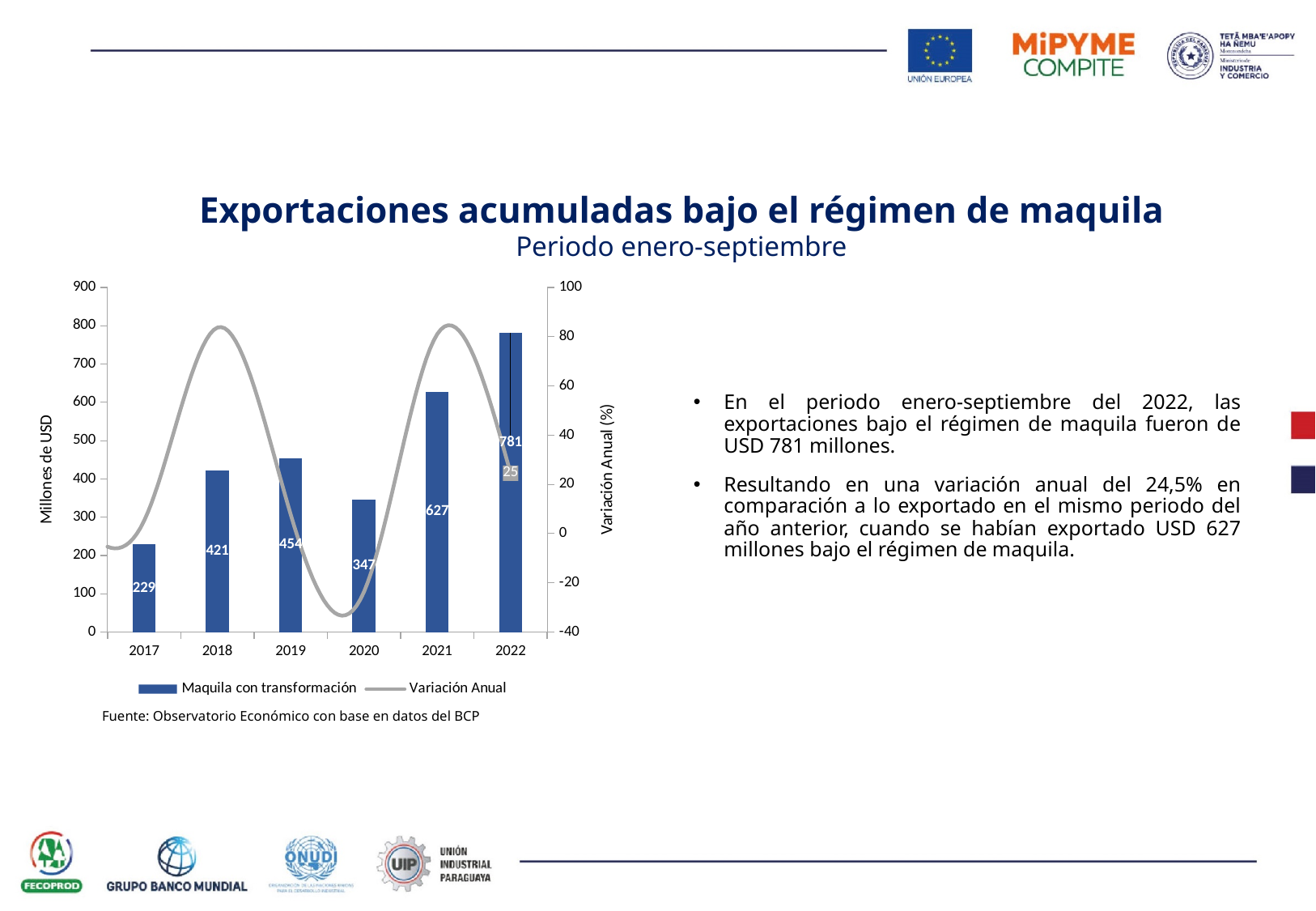
How many series does the legend list? 2 Which year has the lowest value for Maquila con transformación? 2017 Is the Variación Anual value for 2018 greater or less than 60? greater How many years are shown on the x axis? 6 What is the value of Maquila con transformación for 2017? 229 Which year has the highest value for Maquila con transformación? 2022 Which is larger, the Maquila con transformación value for 2019 or for 2020? 2019 What is the difference between the Maquila con transformación values for 2022 and 2021? 154 What is the value of Maquila con transformación for 2022? 781 What is the value of Maquila con transformación for 2020? 347 What kind of chart is used for the Maquila con transformación series? bar chart What is the label of the left vertical axis? Millones de USD